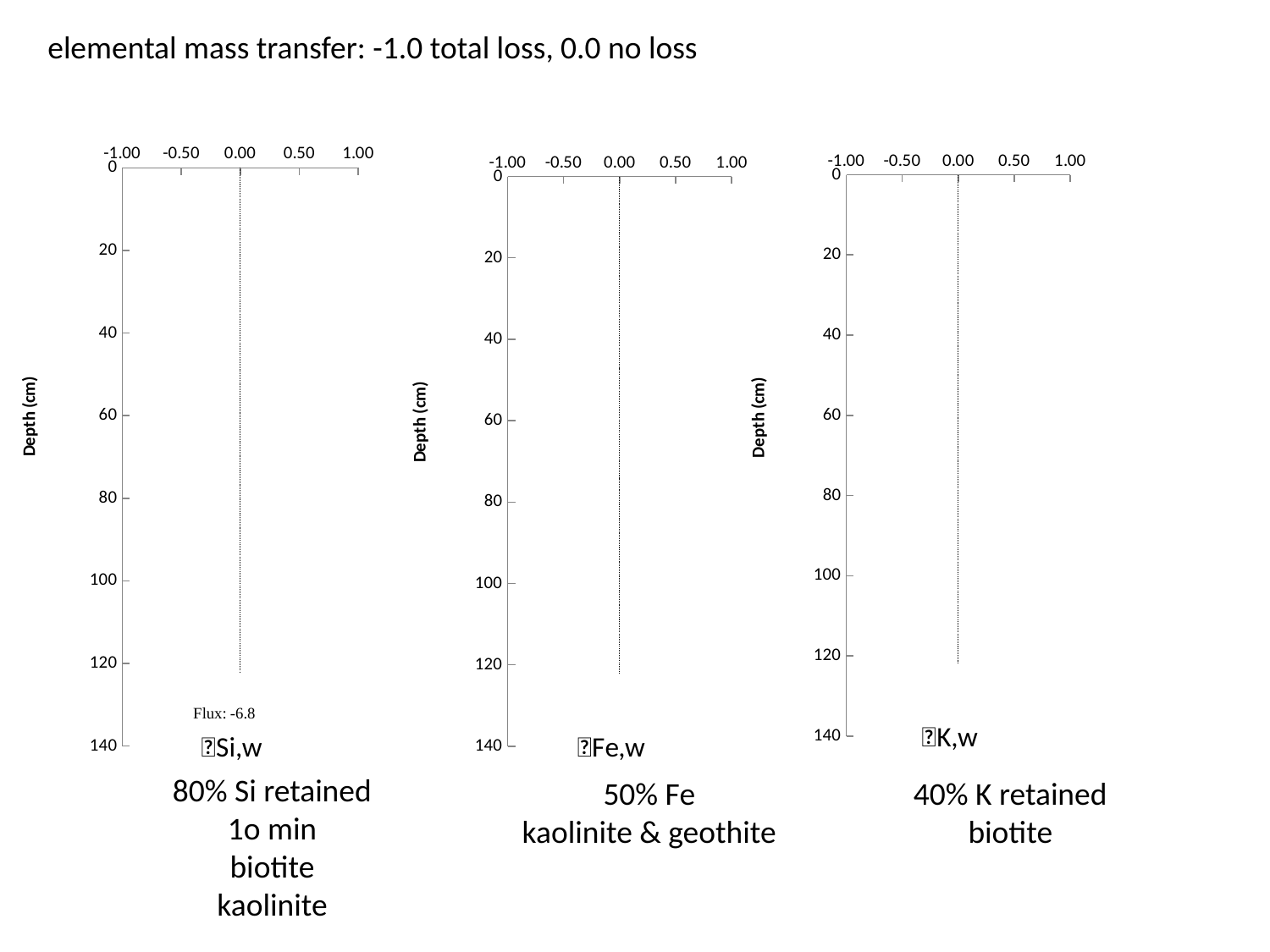
What is the label on the vertical axis of each chart? Depth (cm) How many charts are shown on the slide? 3 On the left chart, what flux value is printed below the plot area? -6.8